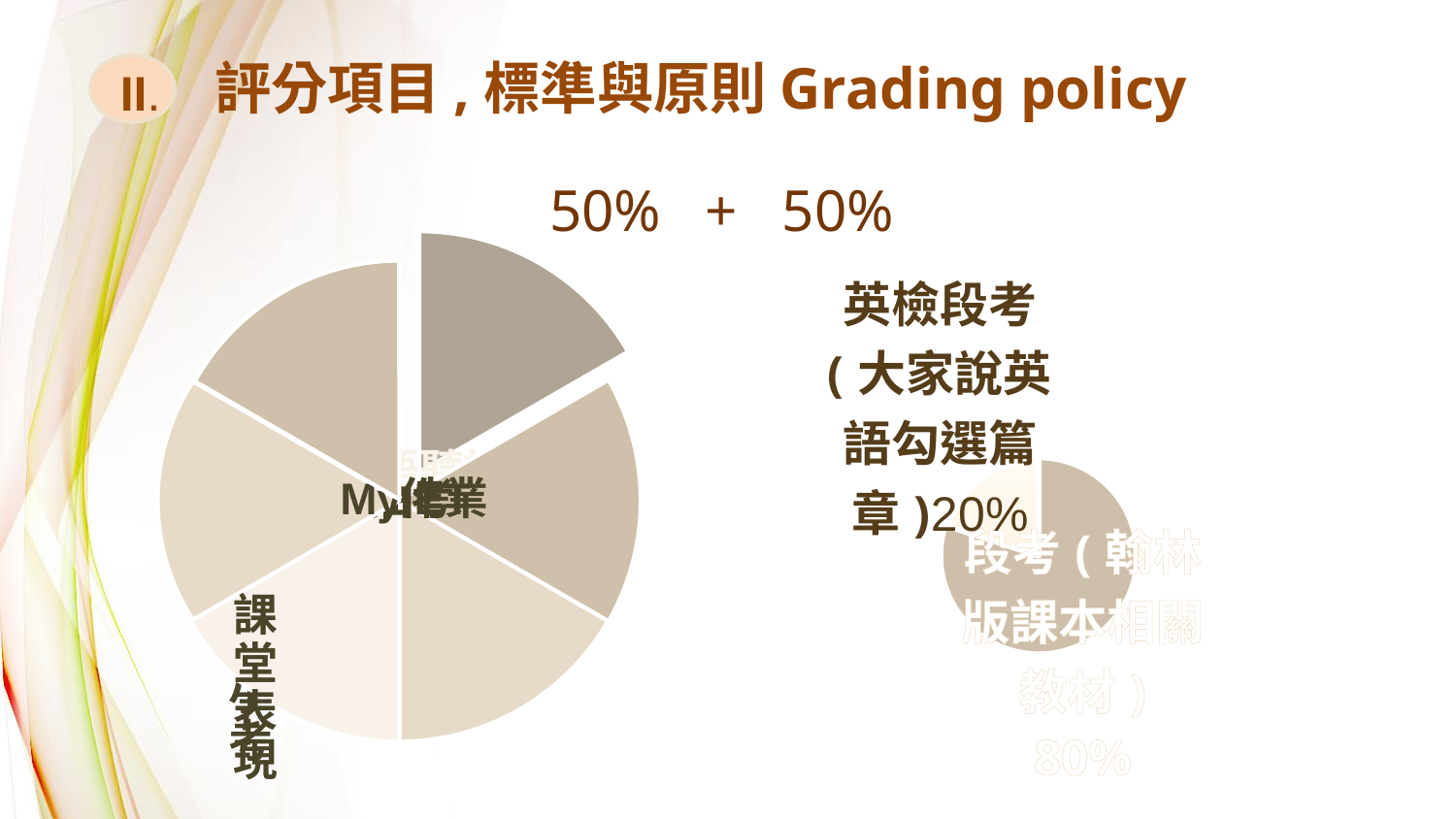
How many slices does the pie chart on the right have? 2 In the pie chart on the right, what share is shown for 英檢段考 (大家說英語勾選篇章)? 20% What kind of chart is the chart on the left side of the slide? pie chart In the pie chart on the right, which slice is the largest? 段考 (翰林版課本相關教材) In the pie chart on the right, which slice is the smallest? 英檢段考 (大家說英語勾選篇章) In the pie chart on the right, what share is shown for 段考 (翰林版課本相關教材)? 80% In the pie chart on the right, which slice is larger: 英檢段考 or 段考 (翰林版課本相關教材)? 段考 (翰林版課本相關教材) In the pie chart on the right, what is the difference between the 段考 (翰林版課本相關教材) share and the 英檢段考 share? 60% What is the title of the slide containing the two pie charts? 評分項目, 標準與原則 Grading policy How many slices does the pie chart on the left have? 6 What weighting is shown above the two pie charts? 50% + 50% What kind of chart is the chart on the right side of the slide? pie chart